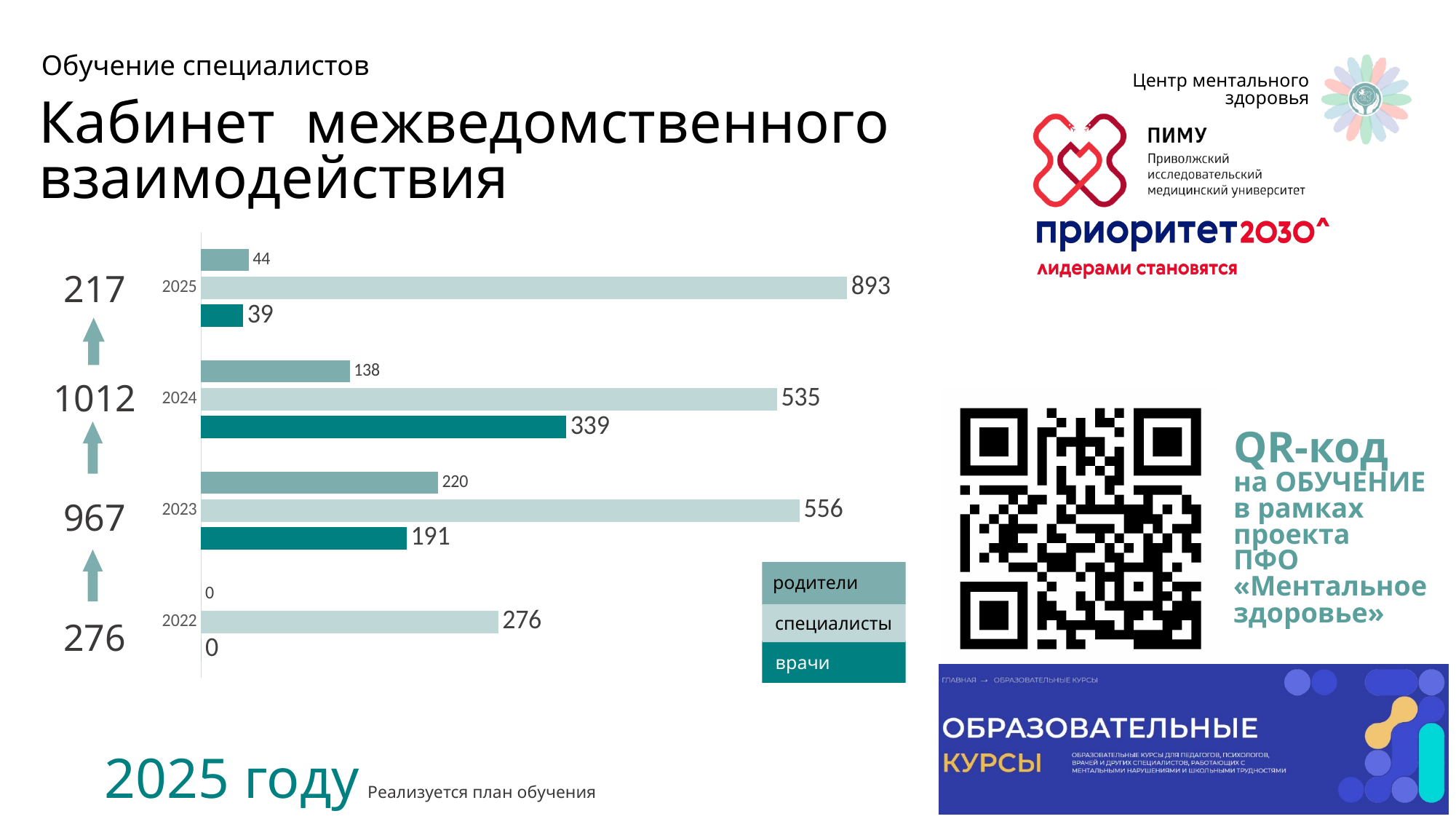
What kind of chart is shown on the slide? bar chart In which year is the value for специалисты highest? 2025 What is the value for родители in 2023? 220 In which year is the value for родители lowest? 2022 What is the total of the three series for 2024? 1012 Which is larger in 2023: родители or врачи? родители What is the value for специалисты in 2022? 276 What is the value for врачи in 2024? 339 How many years are shown on the chart? 4 What is the value for специалисты in 2025? 893 What is the difference between специалисты and врачи in 2024? 196 How many series does the chart legend list? 3